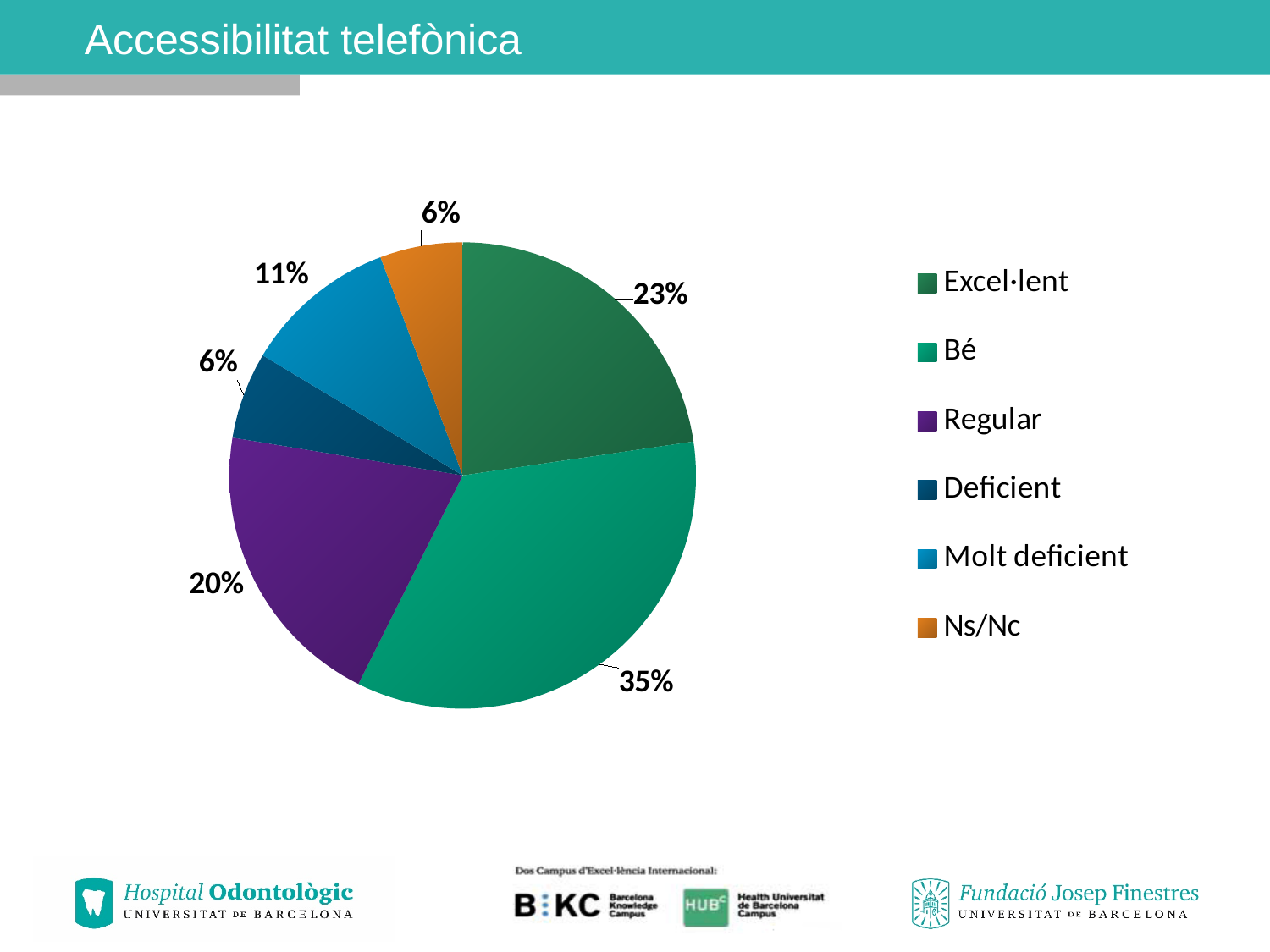
What percentage of the pie corresponds to Molt deficient? 11% What percentage of the pie corresponds to Deficient? 6% What percentage of the pie corresponds to Excel·lent? 23% How many categories does the legend list? 6 What is the title of the slide containing the chart? Accessibilitat telefònica Which is larger, the share for Regular or the share for Molt deficient? Regular Which category has the largest share of the pie? Bé What percentage of the pie corresponds to Bé? 35% What is the difference in percentage points between Bé and Excel·lent? 12 What percentage of the pie corresponds to Regular? 20% What kind of chart is shown on the slide? pie chart What is the combined share of Excel·lent and Bé? 58%